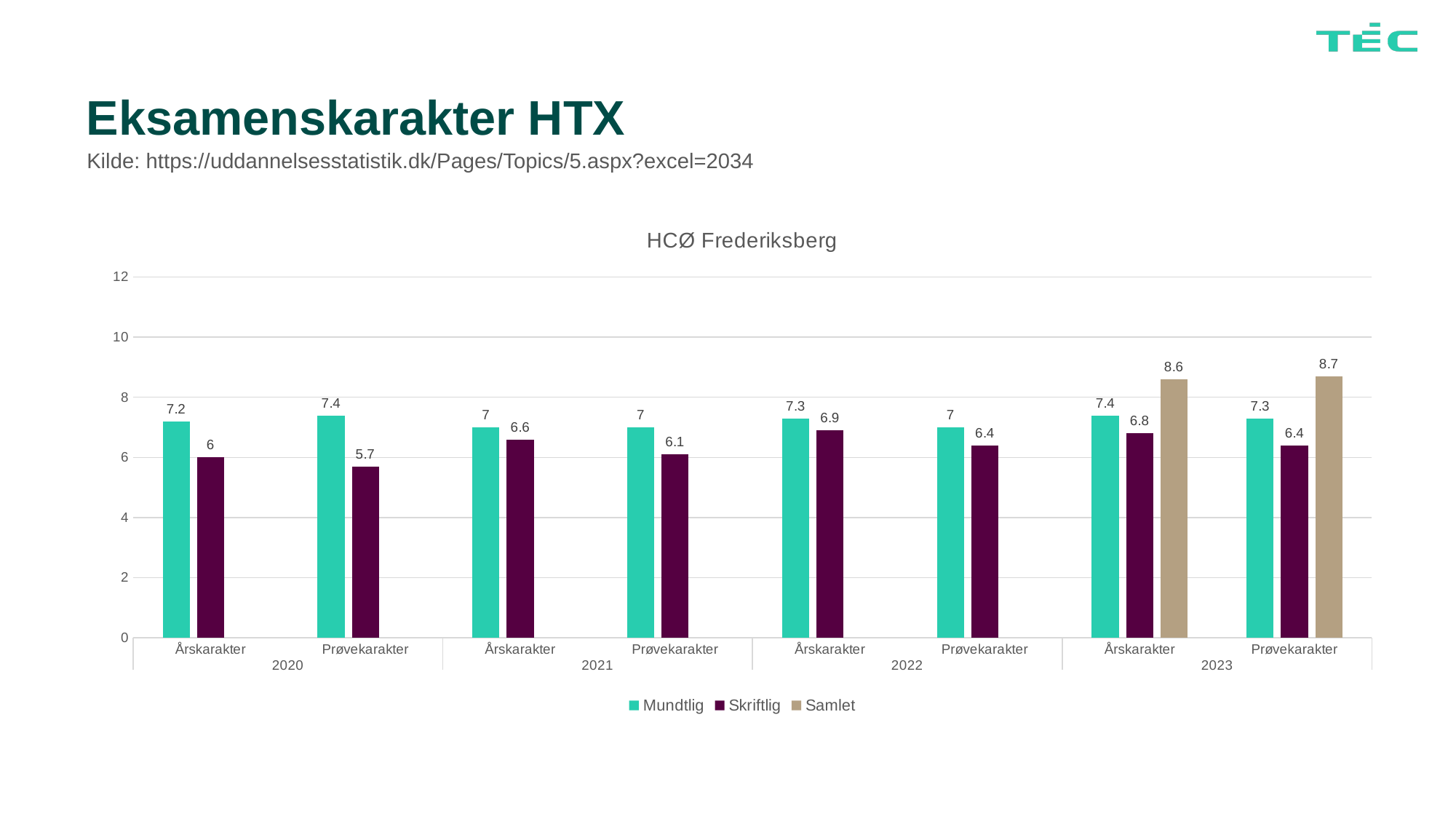
How many series does the legend list? 3 What kind of chart is shown on the slide? Bar chart What is the Mundtlig value for Årskarakter in 2020? 7.2 Which category has the highest Samlet value? Prøvekarakter 2023 What is the Samlet value for Prøvekarakter in 2023? 8.7 Which is larger, the Skriftlig value for Årskarakter in 2021 or for Årskarakter in 2023? Årskarakter 2023 What is the title of the chart? HCØ Frederiksberg Is the Samlet value for Årskarakter in 2023 greater or less than 8? greater What is the difference between the Mundtlig and Skriftlig values for Prøvekarakter in 2020? 1.7 What is the Skriftlig value for Årskarakter in 2022? 6.9 What is the Skriftlig value for Prøvekarakter in 2020? 5.7 Which category has the lowest Skriftlig value? Prøvekarakter 2020